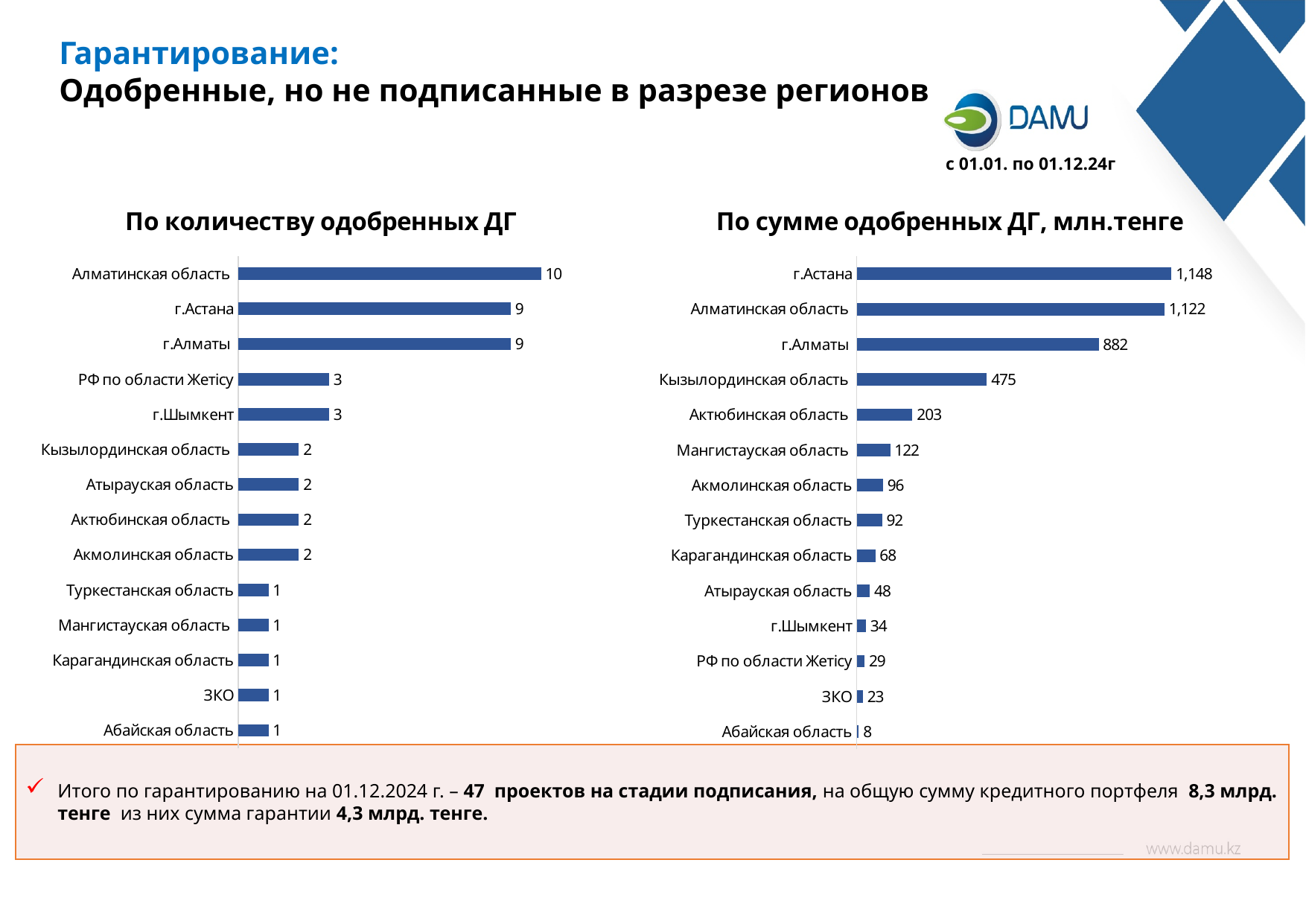
How many regions are shown in the chart 'По количеству одобренных ДГ'? 14 In the chart 'По сумме одобренных ДГ, млн.тенге', which is larger: Актюбинская область or Мангистауская область? Актюбинская область In the chart 'По сумме одобренных ДГ, млн.тенге', what is the difference between г.Астана and Алматинская область? 26 In the chart 'По сумме одобренных ДГ, млн.тенге', which region has the lowest value? Абайская область In the chart 'По сумме одобренных ДГ, млн.тенге', what is the value for Кызылординская область? 475 What is the title of the chart on the left side of the slide? По количеству одобренных ДГ In the chart 'По сумме одобренных ДГ, млн.тенге', which region has the highest value? г.Астана In the chart 'По количеству одобренных ДГ', which region has the highest value? Алматинская область What type of chart is 'По сумме одобренных ДГ, млн.тенге'? Bar chart In the chart 'По сумме одобренных ДГ, млн.тенге', what is the value for г.Алматы? 882 In the chart 'По количеству одобренных ДГ', what is the value for Алматинская область? 10 In the chart 'По количеству одобренных ДГ', what is the difference between Алматинская область and г.Шымкент? 7